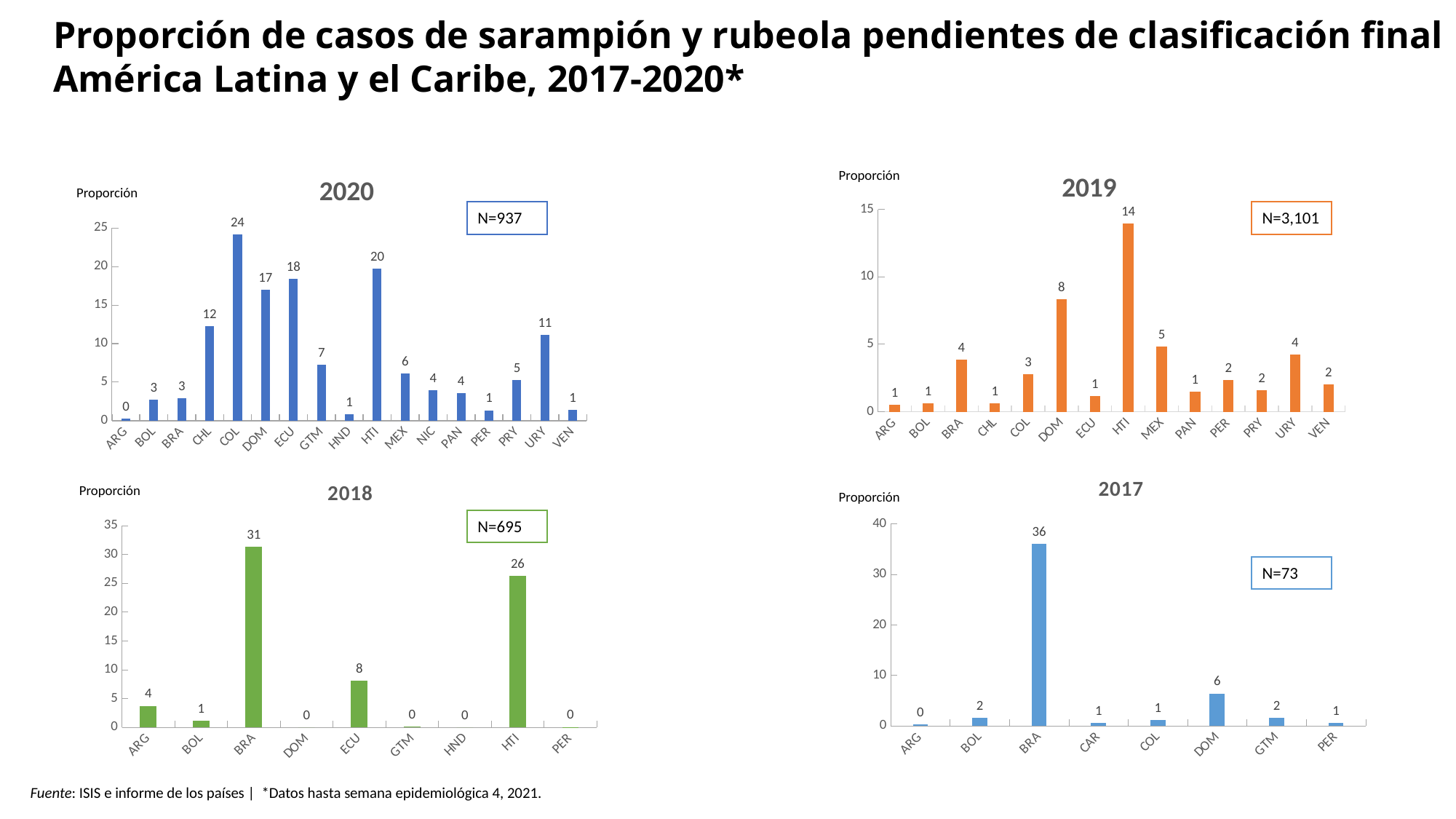
In the 2017 chart, what is the value for DOM? 6 In the 2020 chart, which country has the highest value? COL In the 2020 chart, what is the value for COL? 24 In the 2019 chart, what is the difference between the values for HTI and DOM? 6 In the 2018 chart, how many countries are shown on the x axis? 9 What kind of chart is the 2017 chart? Bar chart In the 2019 chart, which is larger, the value for BRA or the value for MEX? MEX In the 2018 chart, what is the value for BRA? 31 In the 2020 chart, how many countries are shown on the x axis? 17 In the 2018 chart, what is the difference between the values for BRA and HTI? 5 In the 2019 chart, what is the value for HTI? 14 In the 2017 chart, which country has the highest value? BRA